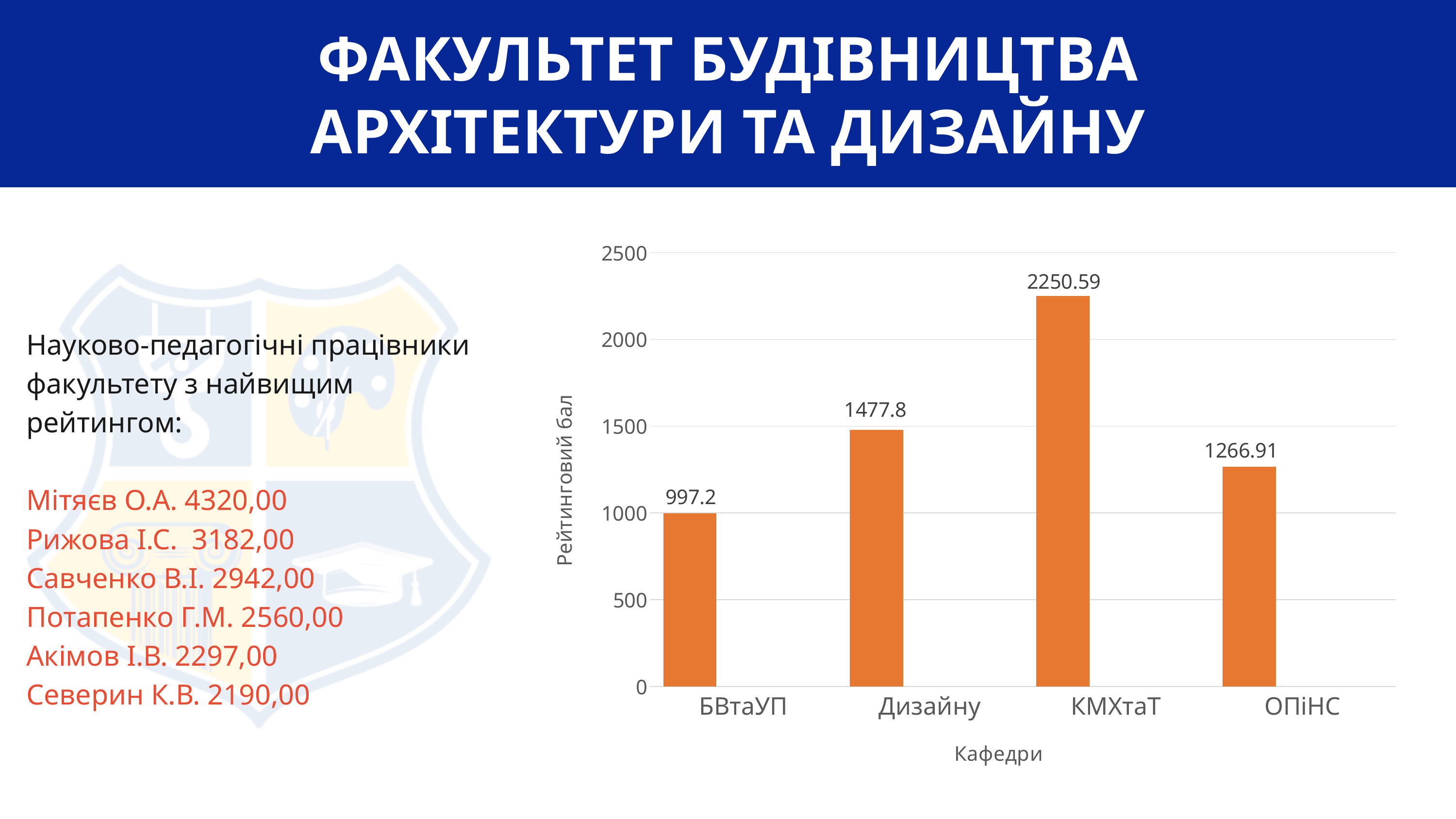
Which department has the lowest rating score? БВтаУП What is the rating score (Рейтинговий бал) for БВтаУП? 997.2 What kind of chart is shown on the slide? Bar chart Is the value for КМХтаТ greater or less than 2000? greater What is the difference between the rating scores of КМХтаТ and БВтаУП? 1253.39 What is the rating score for ОПіНС? 1266.91 What is the difference between the rating scores of Дизайну and ОПіНС? 210.89 What is the rating score for КМХтаТ? 2250.59 How many departments are shown on the chart? 4 What is the rating score for Дизайну? 1477.8 Which department (кафедра) has the highest rating score? КМХтаТ Which has a higher rating score, Дизайну or ОПіНС? Дизайну